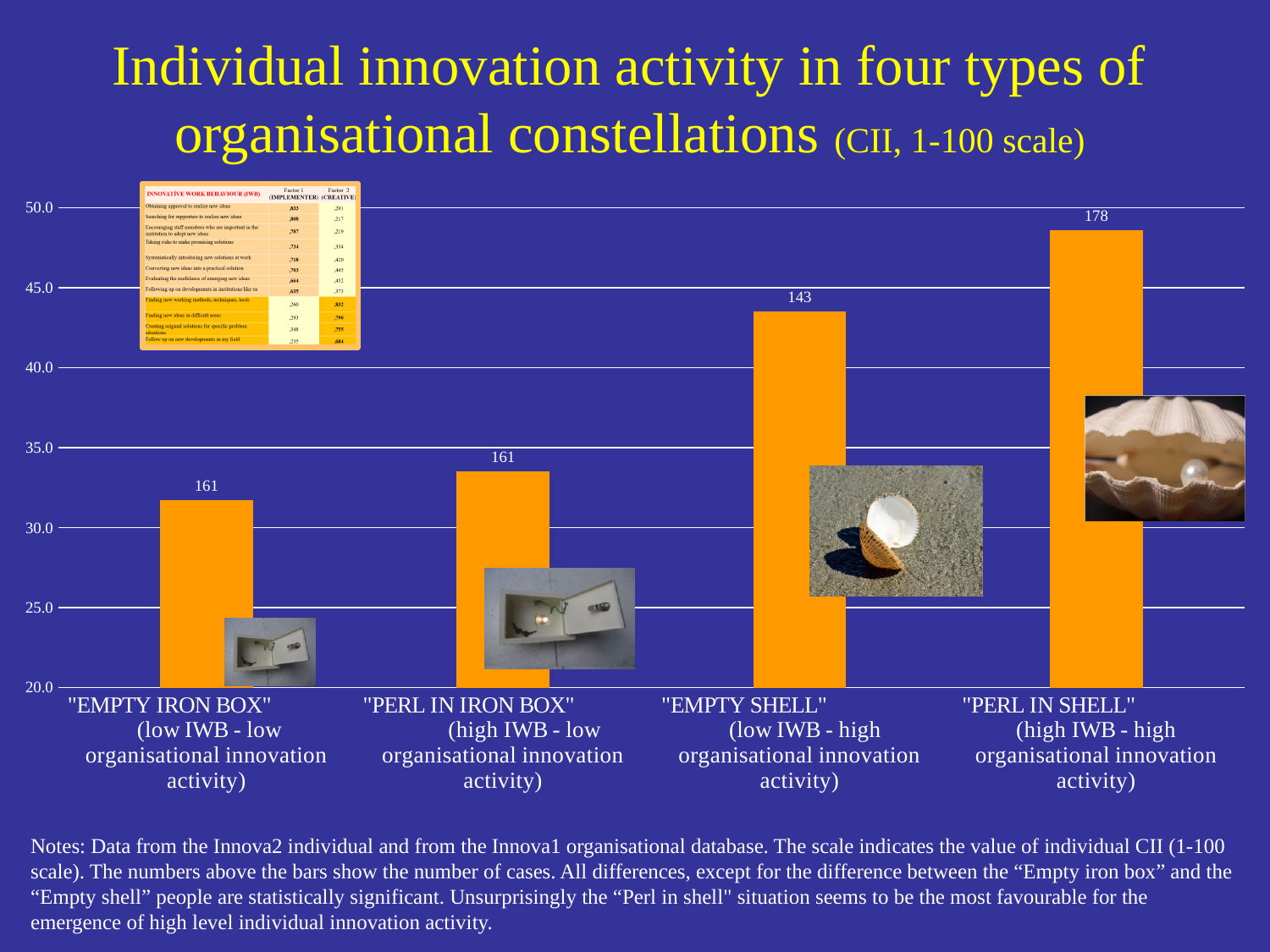
How many more cases are printed above the "PERL IN SHELL" bar than above the "EMPTY SHELL" bar? 35 What number of cases is printed above the bar for "EMPTY SHELL"? 143 How many organisational constellations (categories) are plotted in the chart? 4 Is the value for "EMPTY IRON BOX" greater or less than 35? less Which organisational constellation has the highest bar in the chart? "PERL IN SHELL" Is the value for "EMPTY SHELL" greater or less than 45? less What number of cases is printed above the bar for "PERL IN SHELL"? 178 What number of cases is printed above the bar for "EMPTY IRON BOX"? 161 Which bar is taller, "EMPTY SHELL" or "PERL IN IRON BOX"? "EMPTY SHELL" Is the value for "PERL IN SHELL" greater or less than 45? greater Which organisational constellation has the lowest bar in the chart? "EMPTY IRON BOX" What kind of chart is shown on the slide? bar chart